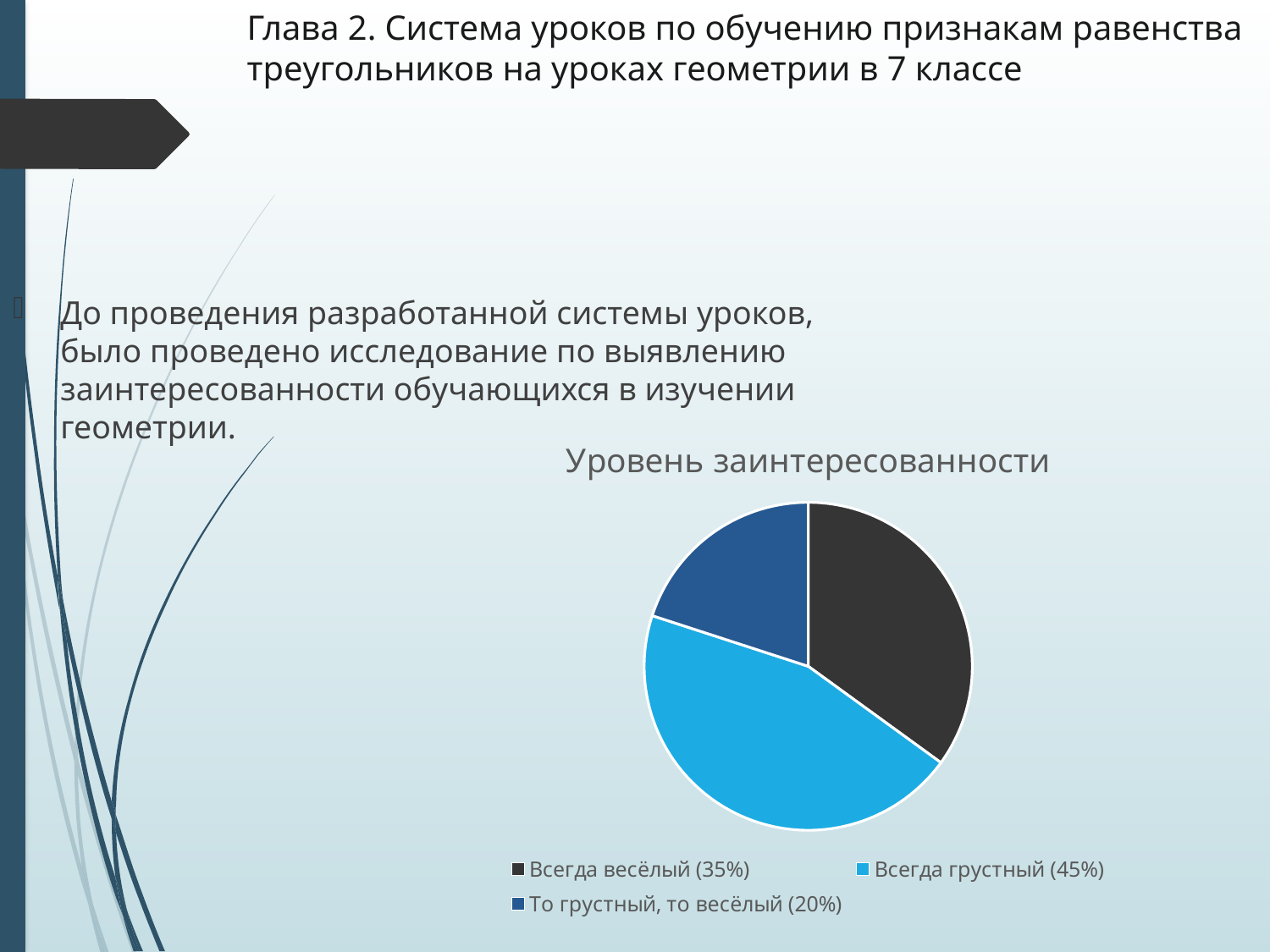
What is the difference in percentage points between "Всегда весёлый" and "То грустный, то весёлый"? 15% What share of the pie does "Всегда весёлый" have? 35% What share of the pie does "Всегда грустный" have? 45% Which is larger: the slice for "Всегда весёлый" or the slice for "То грустный, то весёлый"? Всегда весёлый What colour is the slice for "Всегда грустный"? light blue What is the difference in percentage points between "Всегда грустный" and "Всегда весёлый"? 10% Which category has the largest slice of the pie? Всегда грустный What is the title of the chart? Уровень заинтересованности How many slices does the pie chart have? 3 What type of chart is shown on the slide? pie chart What share of the pie does "То грустный, то весёлый" have? 20% Which category has the smallest slice of the pie? То грустный, то весёлый